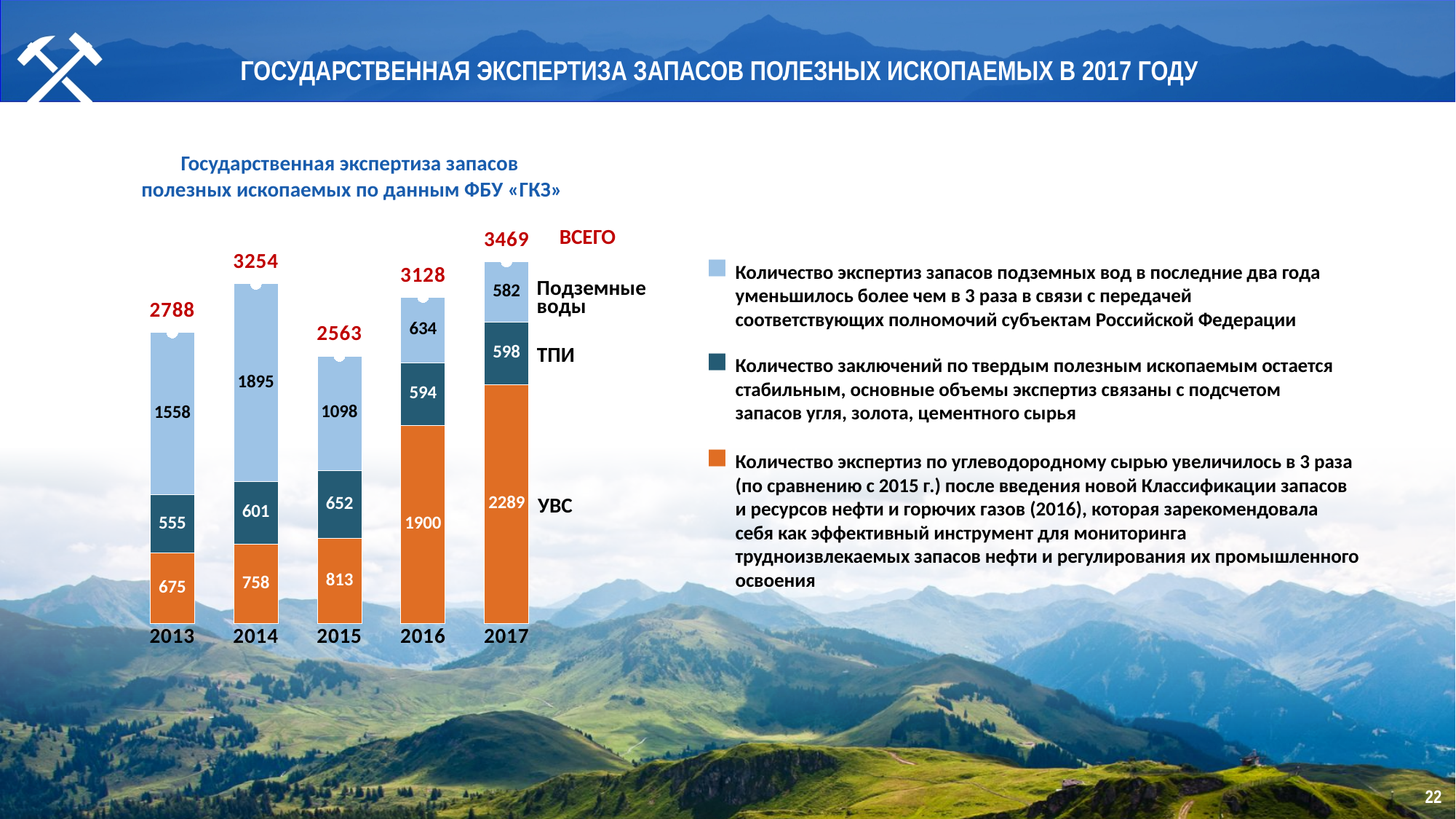
How many years are shown on the x axis? 5 What kind of chart is shown on the slide? Stacked bar chart Which year has the lowest total (ВСЕГО)? 2015 What is the value for УВС in 2017? 2289 Which year has the highest total (ВСЕГО)? 2017 How many series does the chart show? 3 What is the value for Подземные воды in 2014? 1895 What is the difference between the УВС values for 2017 and 2015? 1476 What is the total of the stacked bar for 2016? 3128 What is the value for ТПИ in 2015? 652 Which is larger: Подземные воды in 2013 or Подземные воды in 2017? Подземные воды in 2013 Do the УВС values rise or fall from 2013 to 2017? Rise